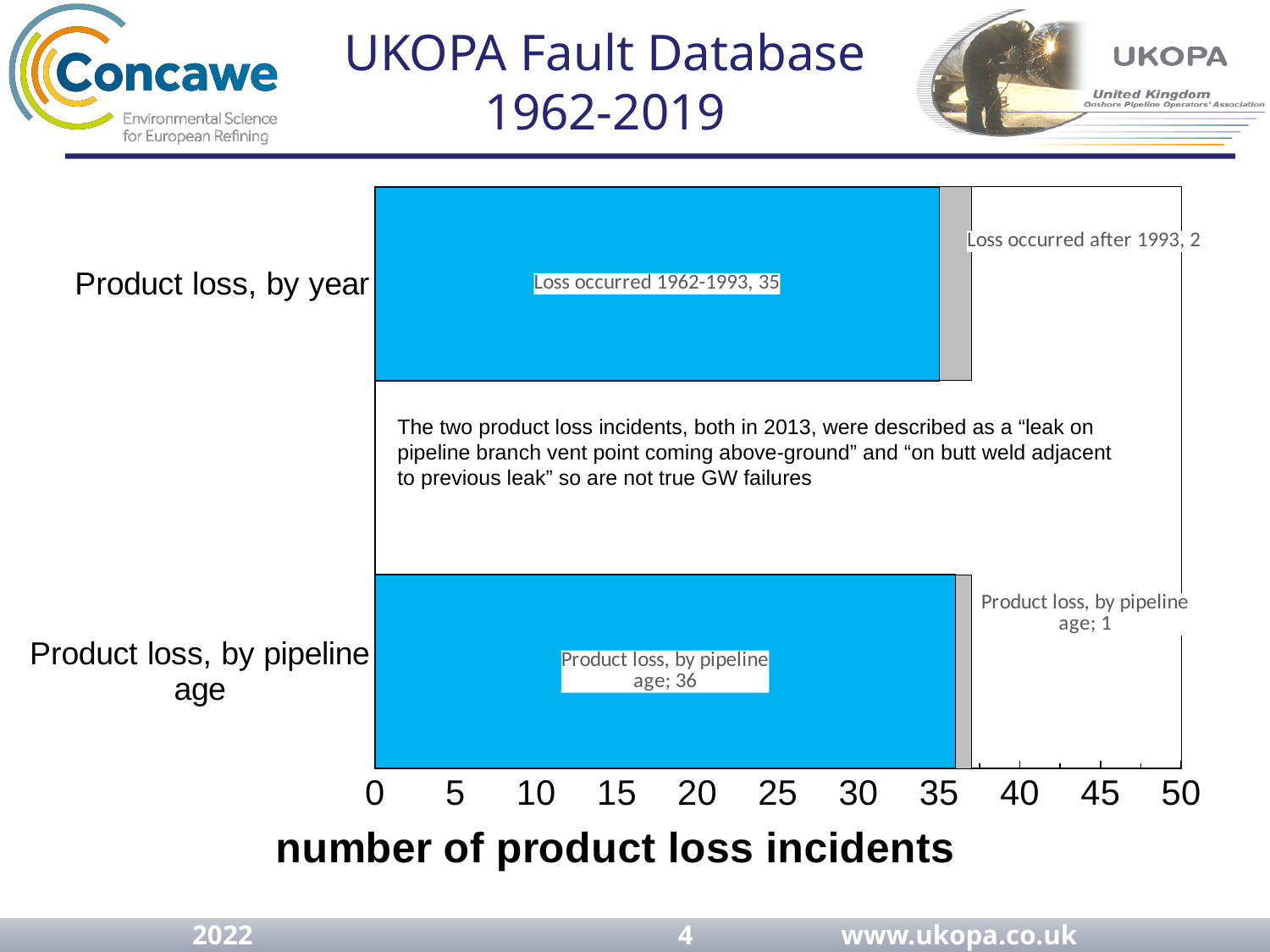
What is the maximum value shown on the horizontal axis of the chart? 50 What kind of chart is shown on the slide? bar chart What is the value of the smaller (grey) segment of the 'Product loss, by pipeline age' bar? 1 What is the total number of product loss incidents in the 'Product loss, by year' bar? 37 How many categories are shown on the vertical axis of the chart? 2 What is the value of the larger (blue) segment of the 'Product loss, by pipeline age' bar? 36 Which is larger: losses that occurred in 1962-1993 or losses that occurred after 1993? Loss occurred 1962-1993 How many product loss incidents occurred after 1993 in the 'Product loss, by year' bar? 2 How many product loss incidents occurred in 1962-1993 in the 'Product loss, by year' bar? 35 What is the title of the horizontal axis of the chart? number of product loss incidents What is the difference between the number of losses that occurred in 1962-1993 and the number that occurred after 1993? 33 What is the total number of product loss incidents in the 'Product loss, by pipeline age' bar? 37